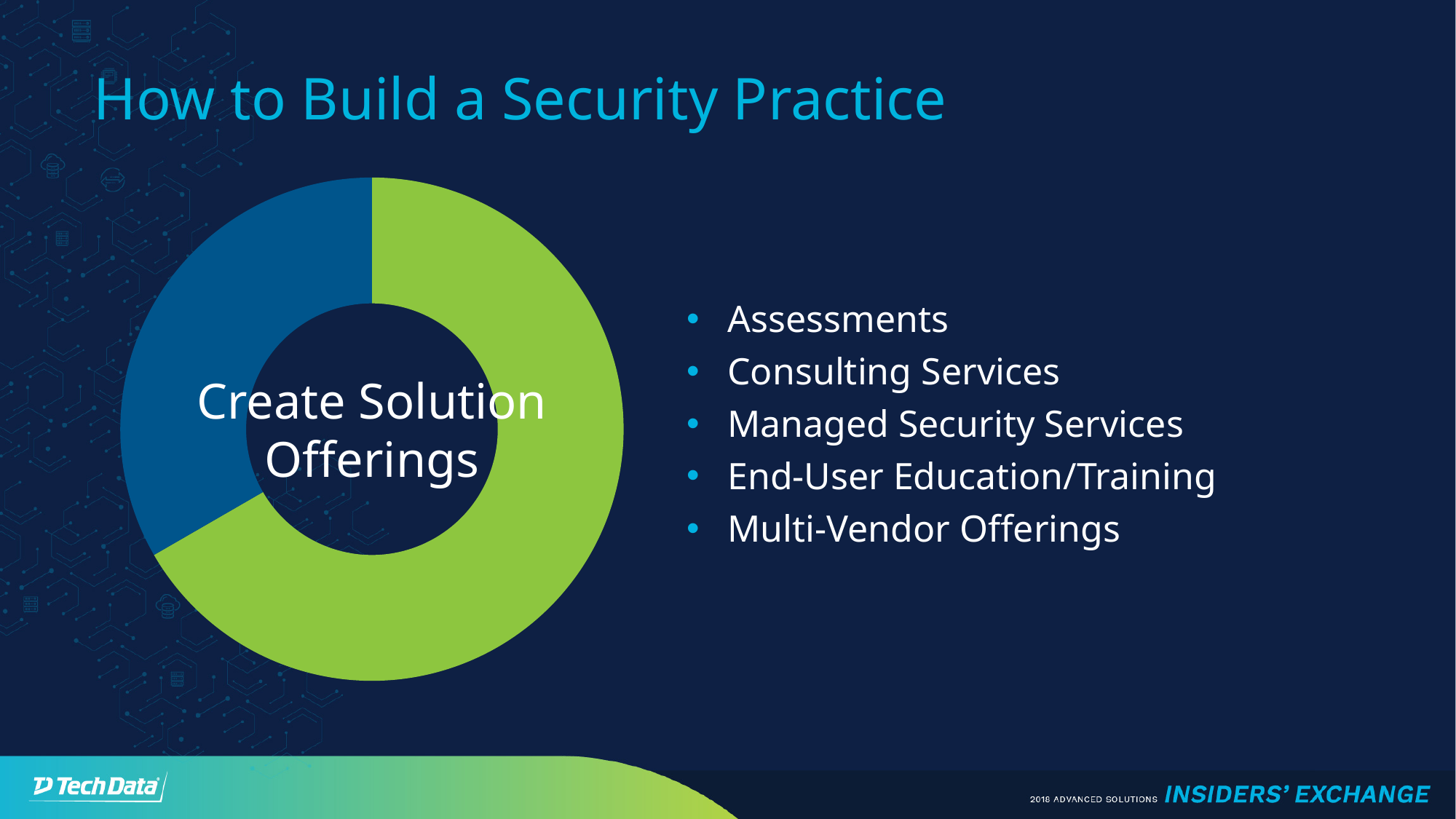
What kind of chart is shown on the slide? Doughnut chart What two colours are used for the segments of the doughnut chart? Green and blue How many segments does the doughnut chart have? 2 Which segment of the doughnut chart is the smallest? The blue segment Which segment of the doughnut chart is larger, the green one or the blue one? The green one What text is written in the centre of the doughnut chart? Create Solution Offerings